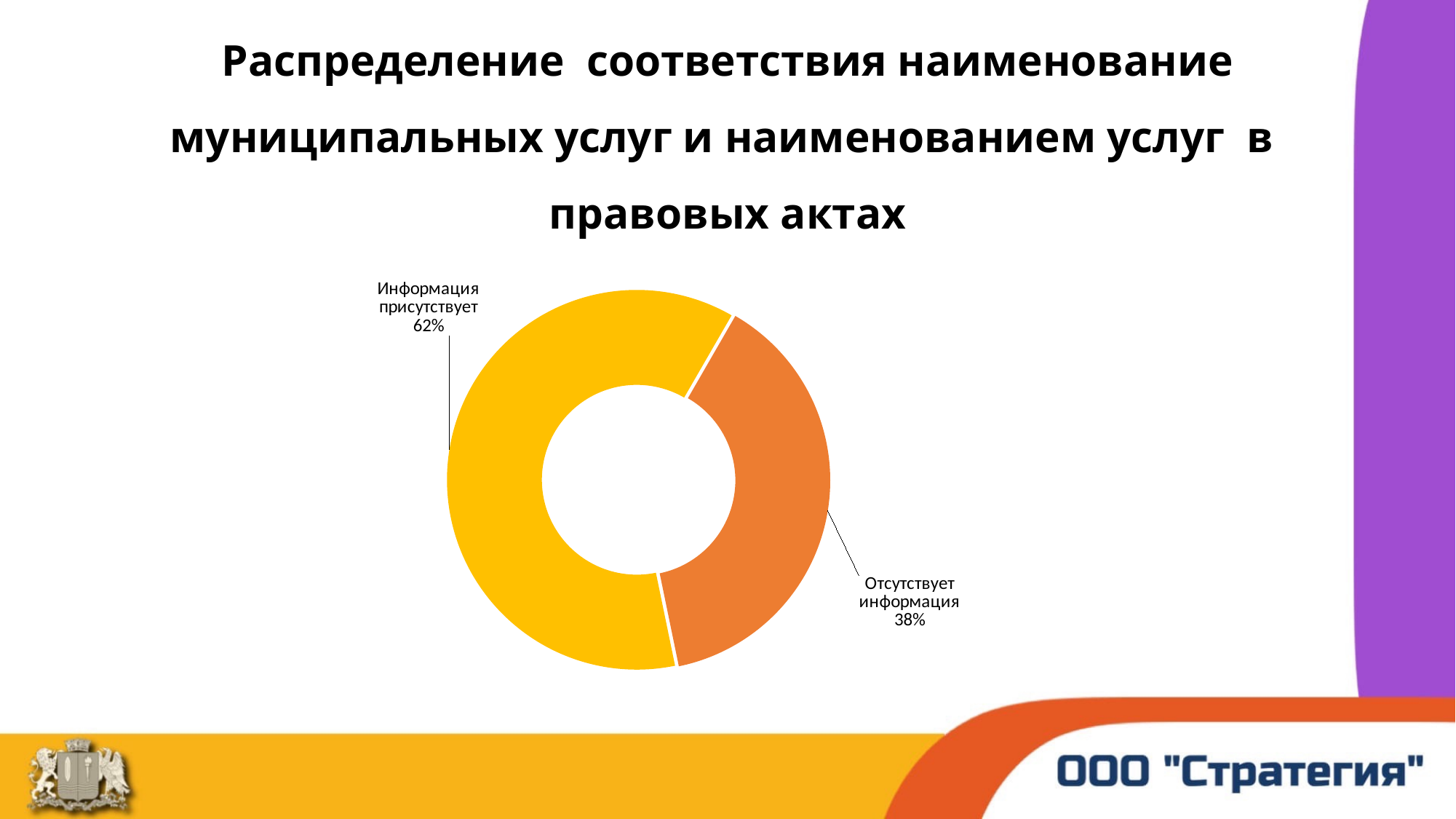
What colour is the "Отсутствует информация" slice? Orange Is the share for "Отсутствует информация" greater or less than 50%? less Which category has the largest share? Информация присутствует Which is larger: "Информация присутствует" or "Отсутствует информация"? Информация присутствует What share of the chart does "Информация присутствует" represent? 62% Which category has the smallest share? Отсутствует информация What share of the chart does "Отсутствует информация" represent? 38% What is the total of the two shares shown in the chart? 100% What kind of chart is shown on the slide? Doughnut (pie) chart What is the difference in percentage points between "Информация присутствует" and "Отсутствует информация"? 24 How many categories are shown in the chart? 2 What colour is the "Информация присутствует" slice? Yellow